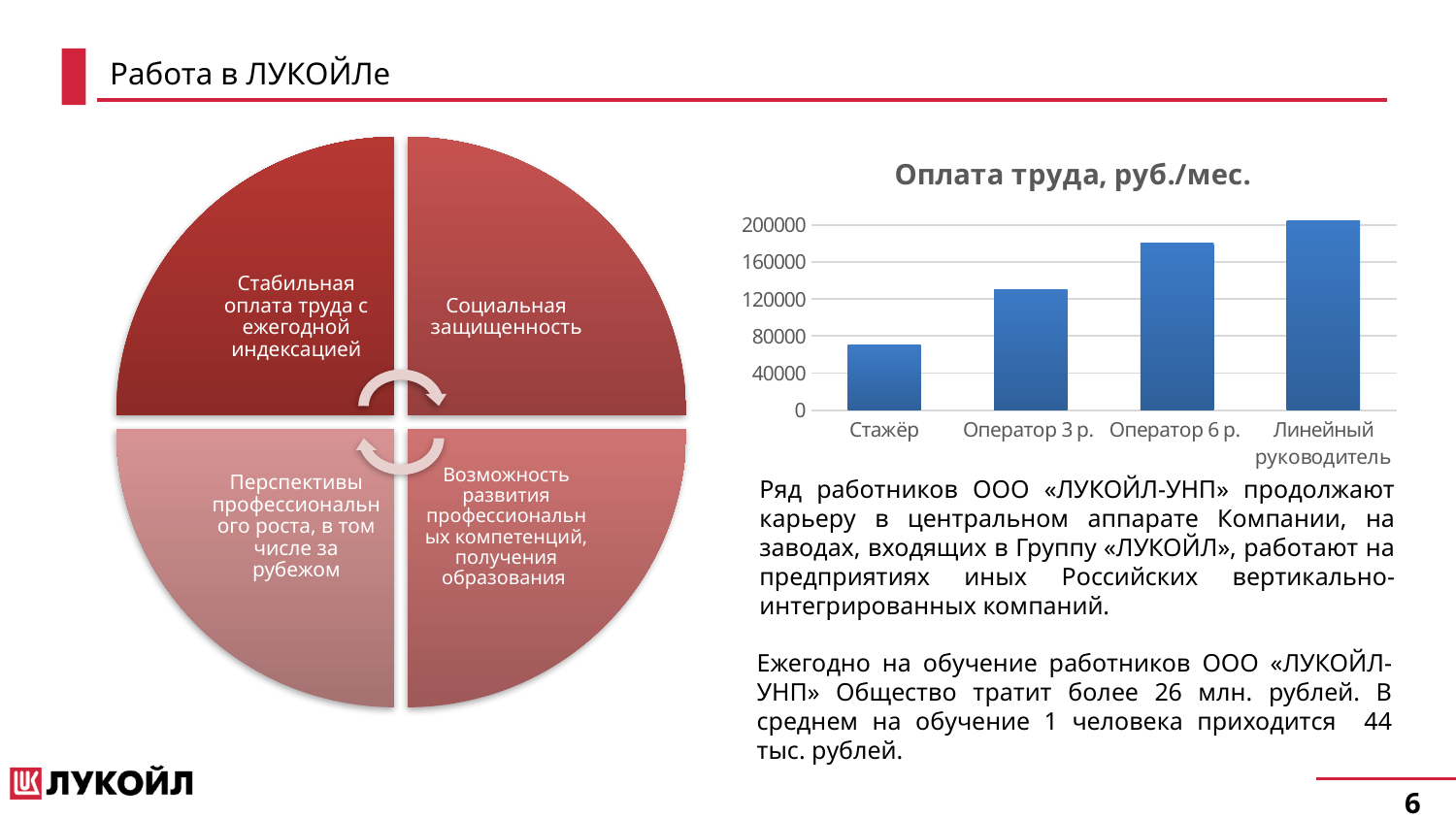
Is the value for Стажёр greater or less than 80000? less Which category has the lowest value in the "Оплата труда, руб./мес." chart? Стажёр Which is larger, the value for Оператор 3 р. or the value for Оператор 6 р.? Оператор 6 р. How many categories are shown on the x axis of the "Оплата труда, руб./мес." chart? 4 Which category has the highest value in the "Оплата труда, руб./мес." chart? Линейный руководитель What is the title of the bar chart on the slide? Оплата труда, руб./мес. Do the values rise or fall from left to right along the x axis of the "Оплата труда, руб./мес." chart? rise Is the value for Линейный руководитель greater or less than 160000? greater What kind of chart is shown under the title "Оплата труда, руб./мес."? bar chart Is the value for Оператор 3 р. greater or less than 120000? greater